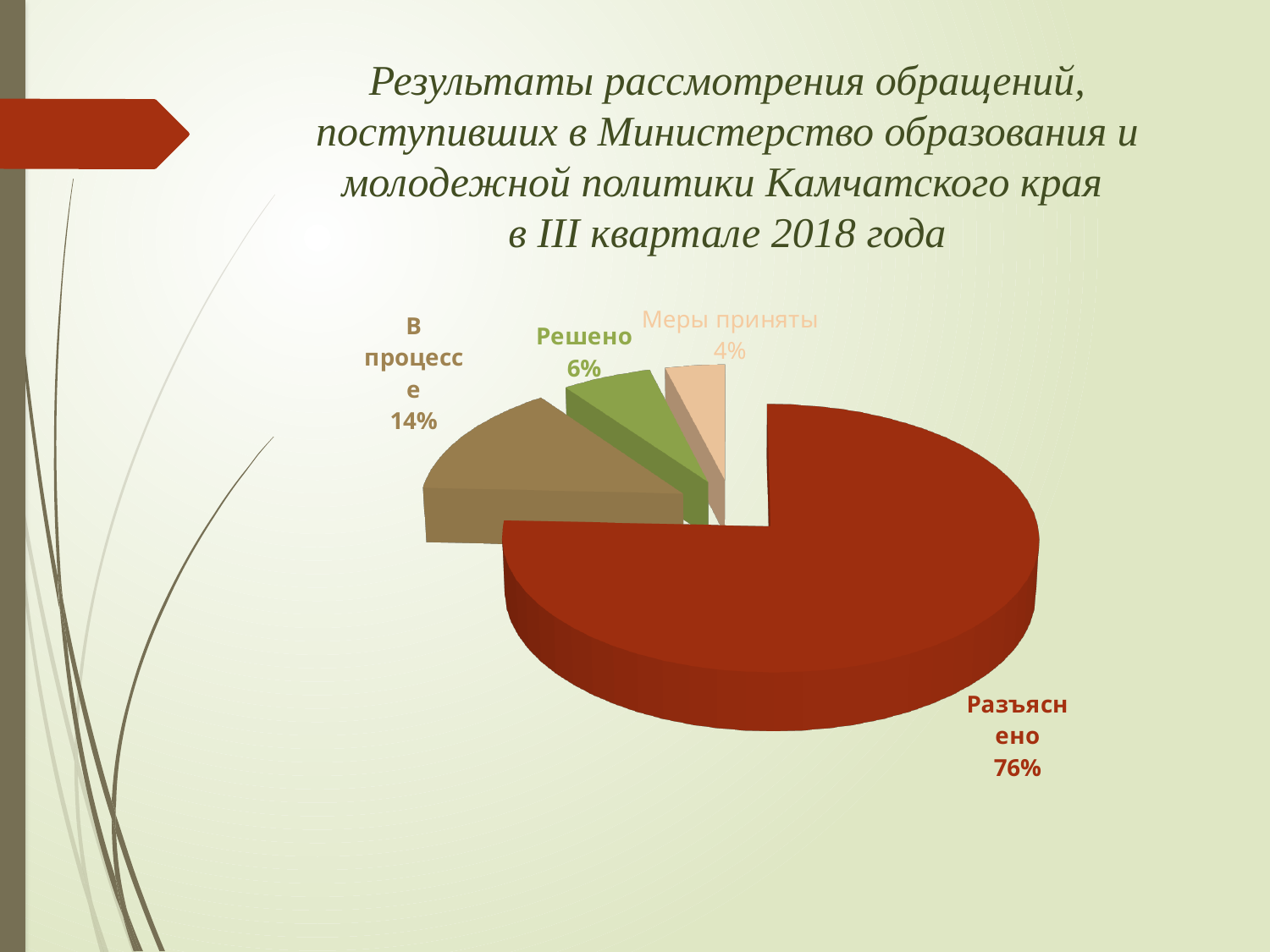
What colour is the "Разъяснено" slice? Red What kind of chart is shown on the slide? Pie chart Which is larger, the share for "В процессе" or the share for "Решено"? В процессе What is the difference in percentage points between "Разъяснено" and "В процессе"? 62 What is the difference in percentage points between "Решено" and "Меры приняты"? 2 Which category has the smallest slice of the pie? Меры приняты How many categories are shown in the pie chart? 4 Which category has the largest slice of the pie? Разъяснено What share of the pie does the "В процессе" slice represent? 14% What is the value shown for "Меры приняты"? 4% What is the value shown for "Решено"? 6% What share of the pie does the "Разъяснено" slice represent? 76%